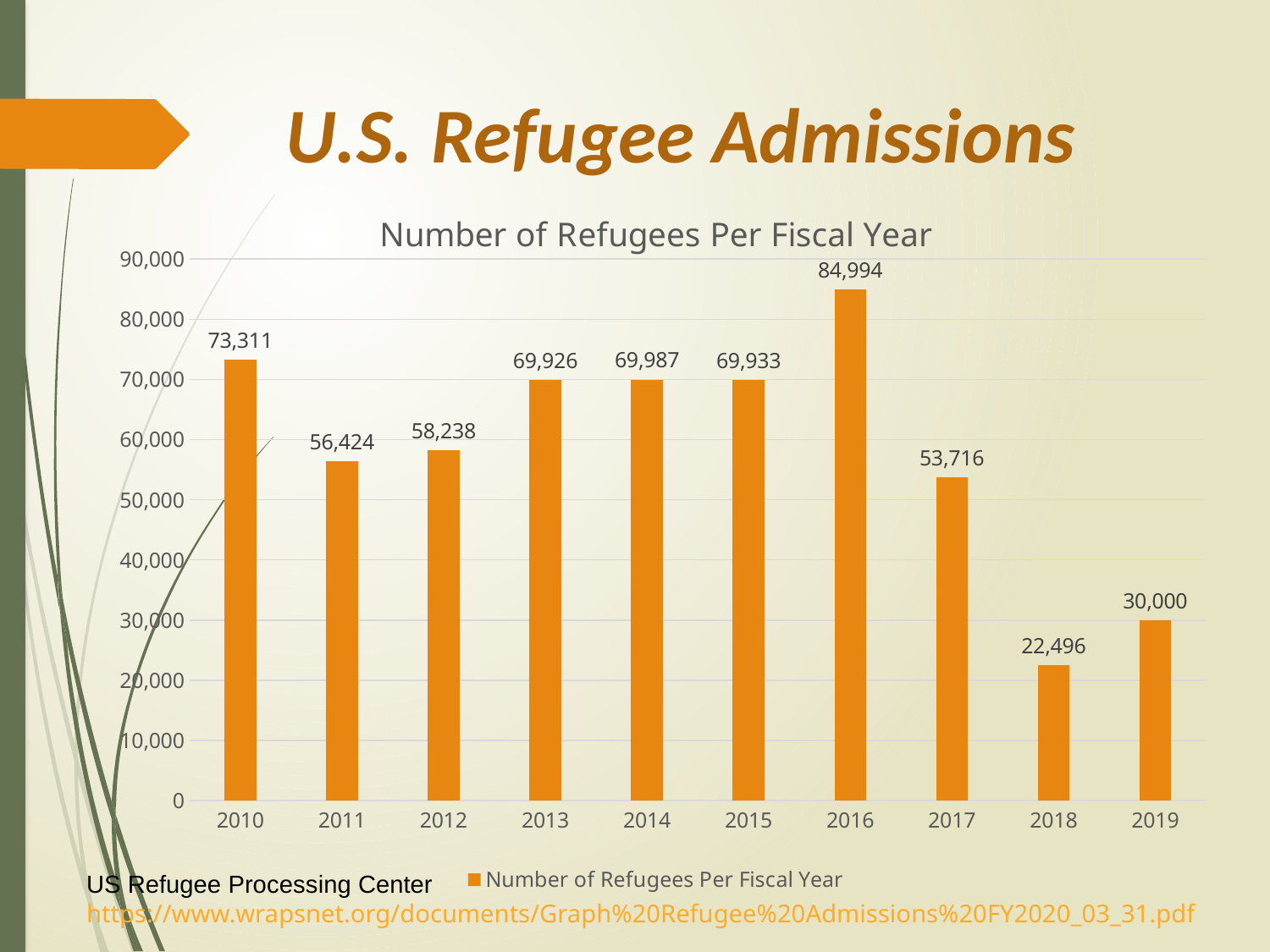
What is the number of refugees for fiscal year 2016? 84,994 What is the difference between the number of refugees in 2019 and in 2018? 7,504 What is the number of refugees for fiscal year 2018? 22,496 What is the number of refugees for fiscal year 2010? 73,311 Which fiscal year has the lowest number of refugees? 2018 How many fiscal years are shown on the x axis? 10 What is the title of the chart? Number of Refugees Per Fiscal Year Which fiscal year had more refugees, 2012 or 2011? 2012 Is the value for 2017 greater or less than 60,000? less What is the difference between the number of refugees in 2016 and in 2017? 31,278 What kind of chart is shown on the slide? Bar chart Which fiscal year has the highest number of refugees? 2016